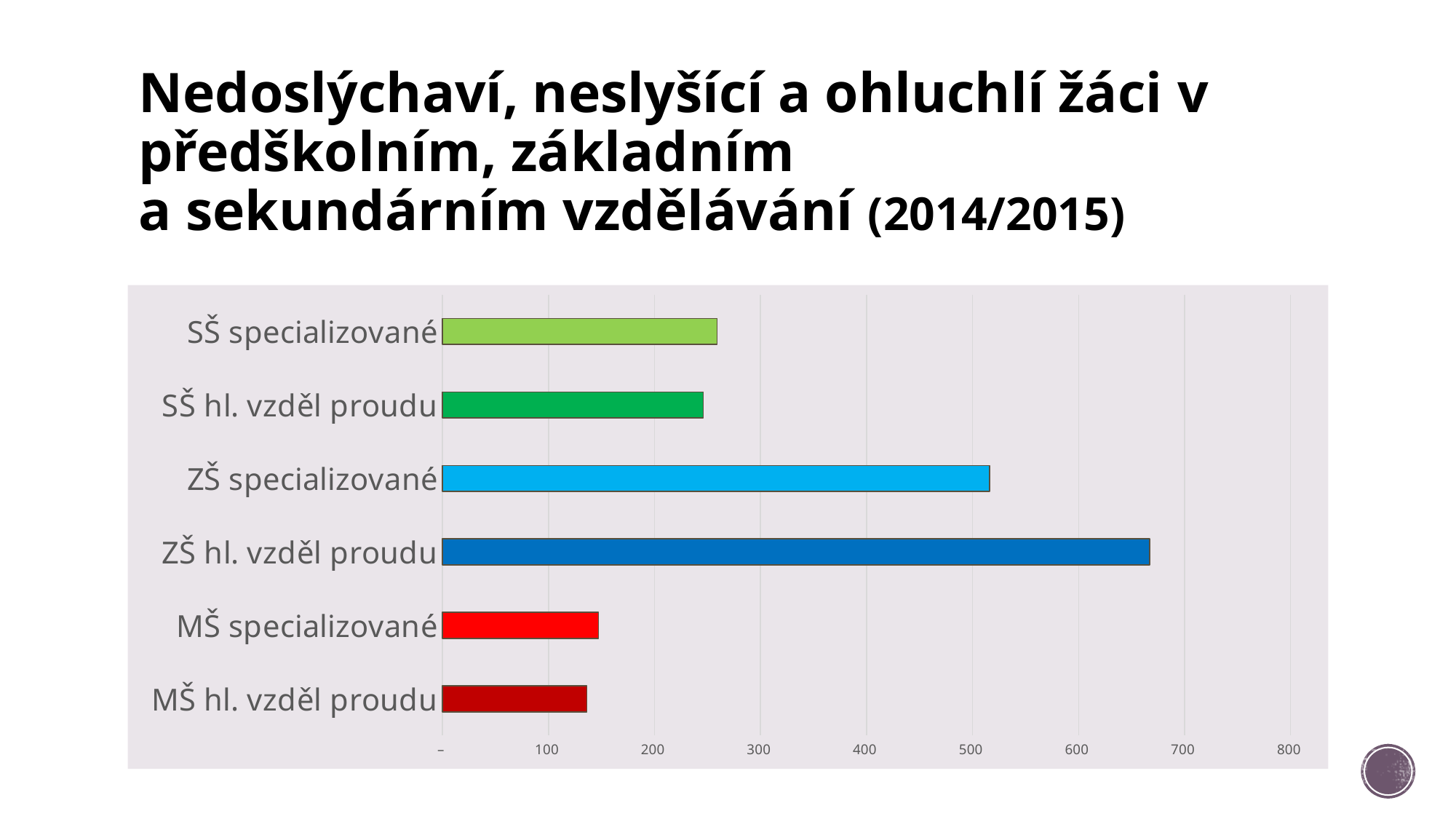
Is the value for ZŠ hl. vzděl proudu greater or less than 600? greater Is the value for ZŠ specializované greater or less than 500? greater Is the value for SŠ hl. vzděl proudu greater or less than 200? greater What school year is given in the slide title? 2014/2015 Which is larger, the value for SŠ specializované or MŠ specializované? SŠ specializované Which category has the highest value? ZŠ hl. vzděl proudu Which is larger, the value for ZŠ hl. vzděl proudu or ZŠ specializované? ZŠ hl. vzděl proudu What kind of chart is shown on the slide? bar chart Which category has the lowest value? MŠ hl. vzděl proudu How many categories are plotted in the chart? 6